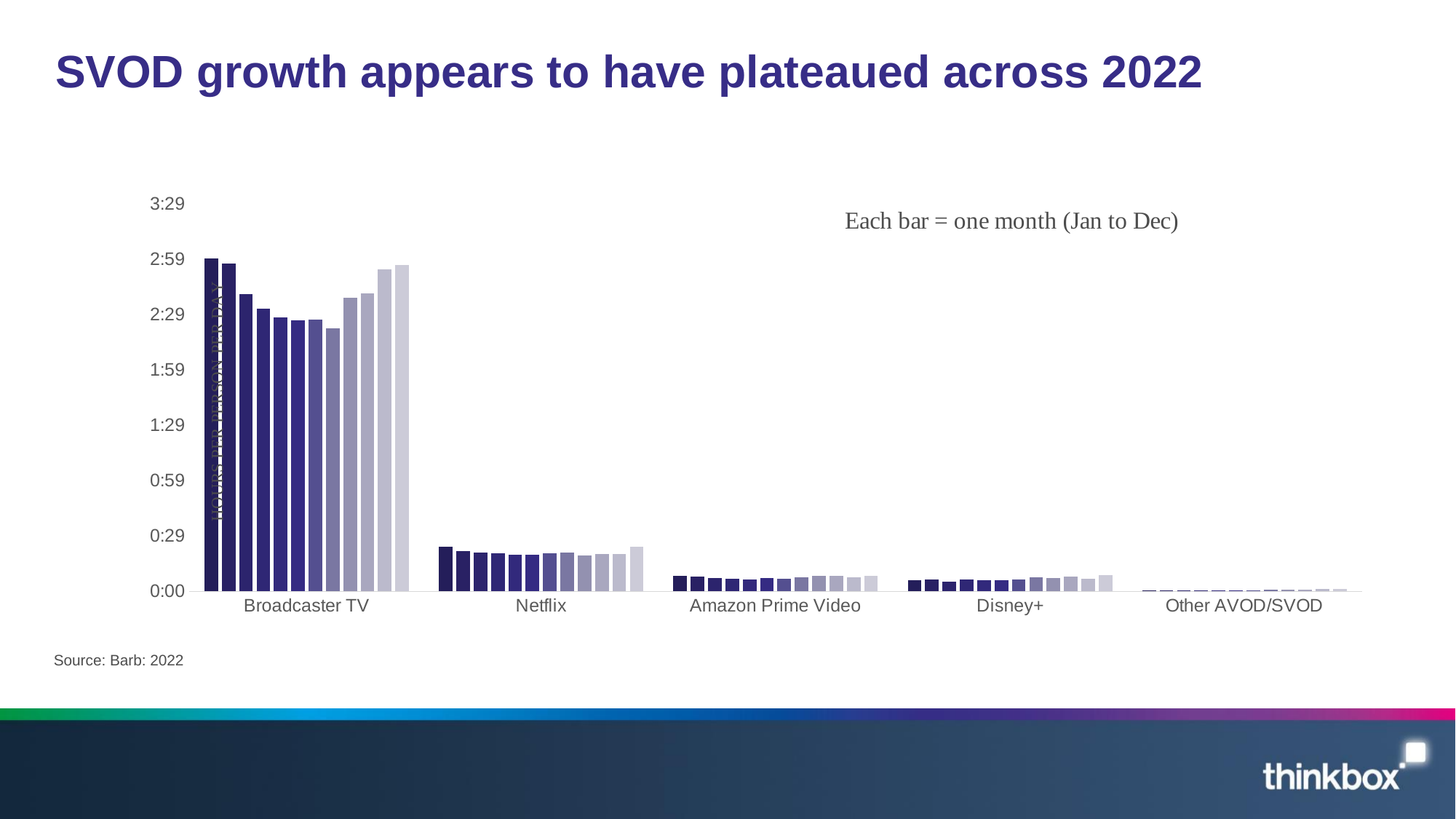
Are the bars for Disney+ greater or less than 0:29? less Is the first (January) bar for Broadcaster TV greater or less than 2:29? greater How many categories are shown along the x axis of the chart? 5 According to the annotation on the chart, what does each bar represent? one month (Jan to Dec) How many bars are plotted for each category on the chart? 12 Is the lowest bar for Broadcaster TV greater or less than 1:59? greater What kind of chart is shown on the slide? bar chart Are the bars for Netflix higher or lower than the bars for Amazon Prime Video? higher Which category has the highest bars on the chart? Broadcaster TV What is the title of the slide? SVOD growth appears to have plateaued across 2022 Which category has the lowest bars on the chart? Other AVOD/SVOD